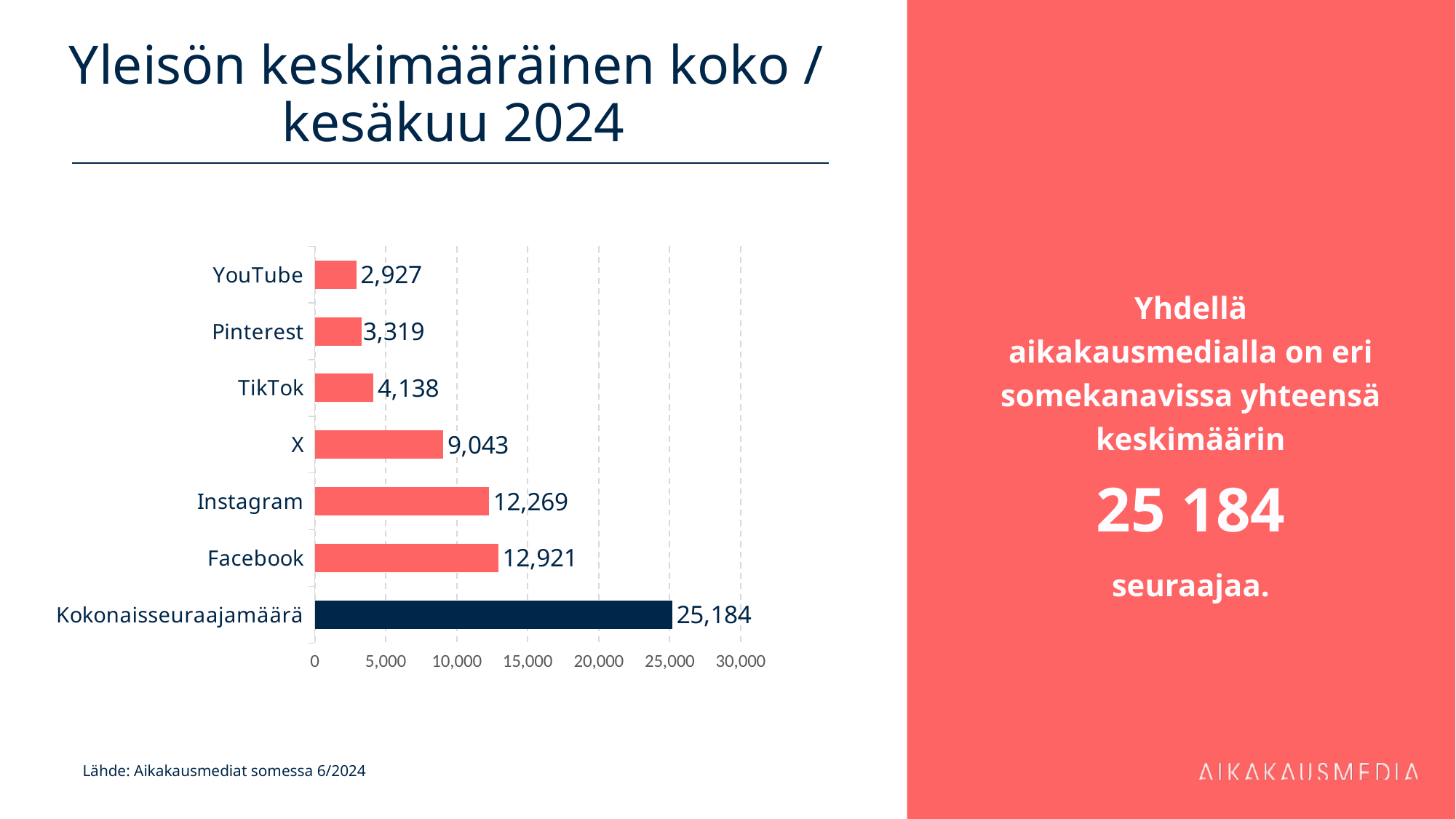
Which category has the lowest value? YouTube What is the title of the slide? Yleisön keskimääräinen koko / kesäkuu 2024 Which category has the highest value? Kokonaisseuraajamäärä Is the value for X greater or less than 10,000? less What kind of chart is shown on the slide? bar chart What is the value for TikTok? 4,138 What is the difference between the values for X and TikTok? 4,905 What is the difference between the values for Facebook and Instagram? 652 What is the value for Facebook? 12,921 What is the value for Kokonaisseuraajamäärä? 25,184 Which is larger, the value for Pinterest or the value for YouTube? Pinterest How many categories are shown in the chart? 7